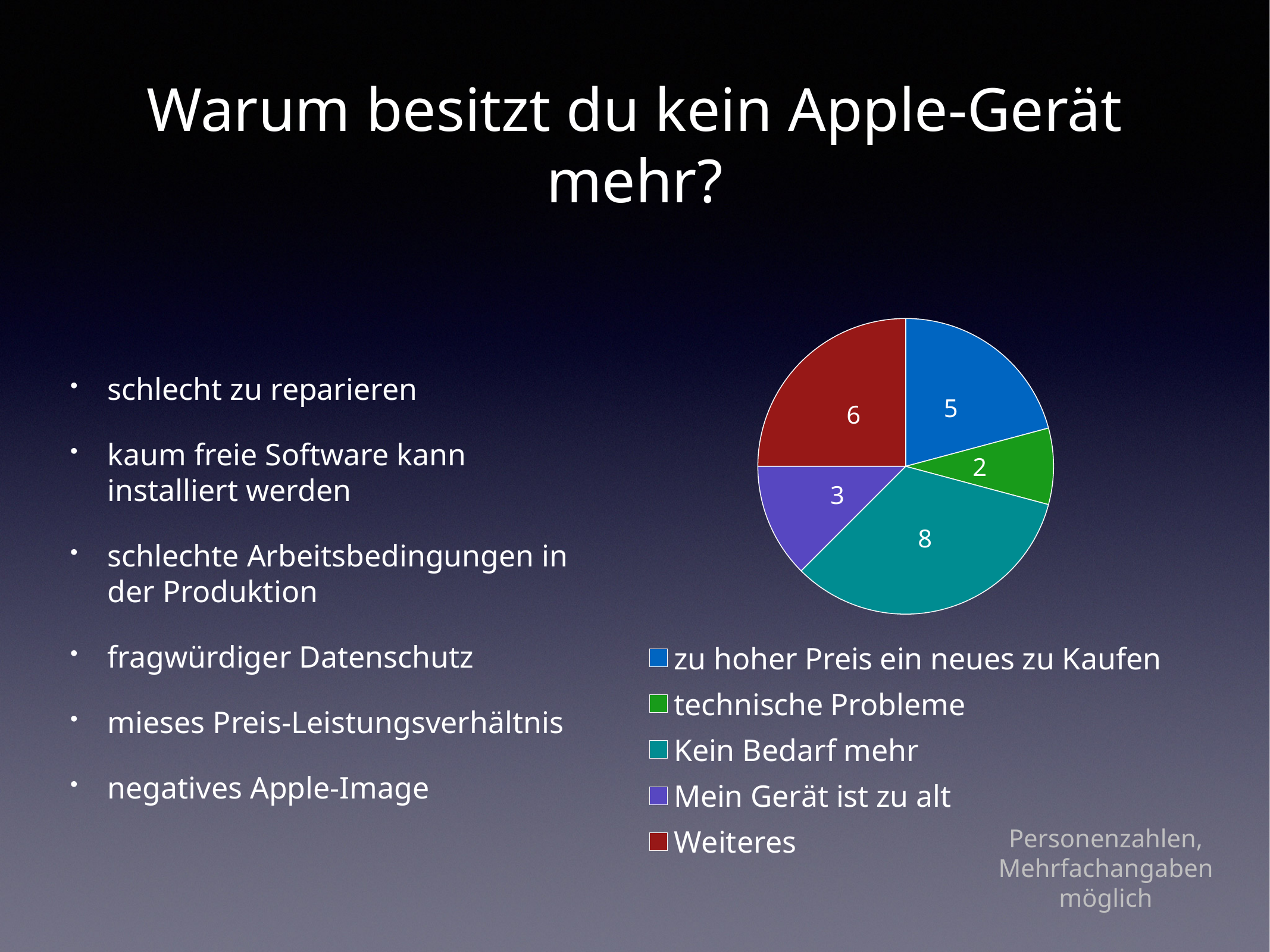
What is the value for "Mein Gerät ist zu alt" in the pie chart? 3 What is the total of all values shown in the pie chart? 24 Which category has the largest slice in the pie chart? Kein Bedarf mehr What kind of chart is shown on the slide? pie chart How many slices does the pie chart have? 5 What is the difference between the values for "Kein Bedarf mehr" and "Weiteres"? 2 Which category has the smallest slice in the pie chart? technische Probleme What is the value for "zu hoher Preis ein neues zu Kaufen" in the pie chart? 5 What share of the pie does "Weiteres" represent? 25% Which is larger: the value for "Weiteres" or the value for "zu hoher Preis ein neues zu Kaufen"? Weiteres What is the value for "Kein Bedarf mehr" in the pie chart? 8 What is the value for "technische Probleme" in the pie chart? 2